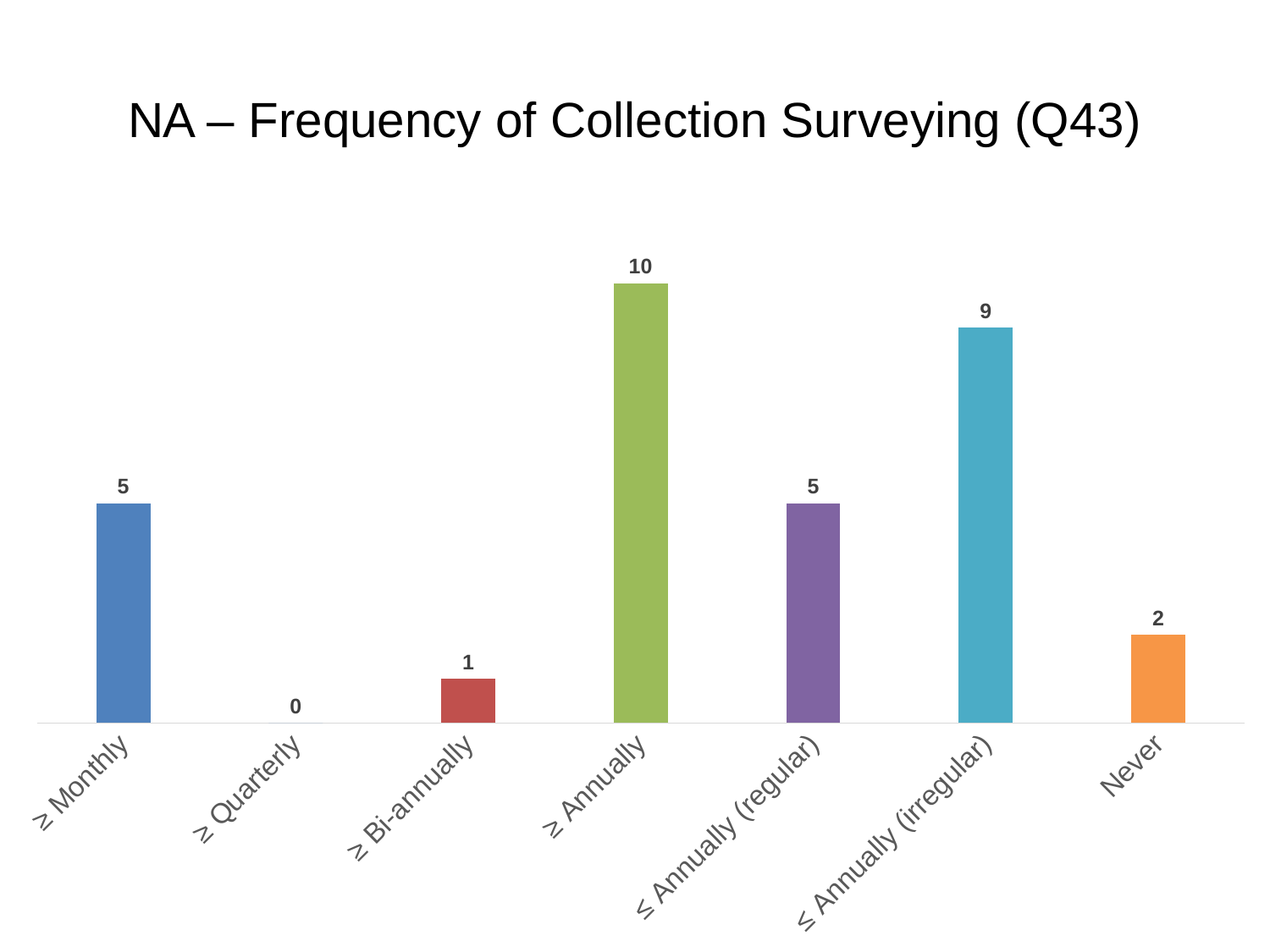
Which category has the lowest value? ≥ Quarterly What is the value for ≤ Annually (irregular)? 9 What is the difference between the values for ≥ Annually and ≤ Annually (irregular)? 1 Which category has the highest value? ≥ Annually What is the title of the chart? NA – Frequency of Collection Surveying (Q43) How many categories are shown on the x axis? 7 What is the value for Never? 2 What is the value for ≥ Quarterly? 0 What kind of chart is shown on the slide? Bar chart What is the difference between the values for ≥ Monthly and Never? 3 What is the value for ≥ Annually? 10 Which is larger, the value for ≥ Bi-annually or the value for Never? Never